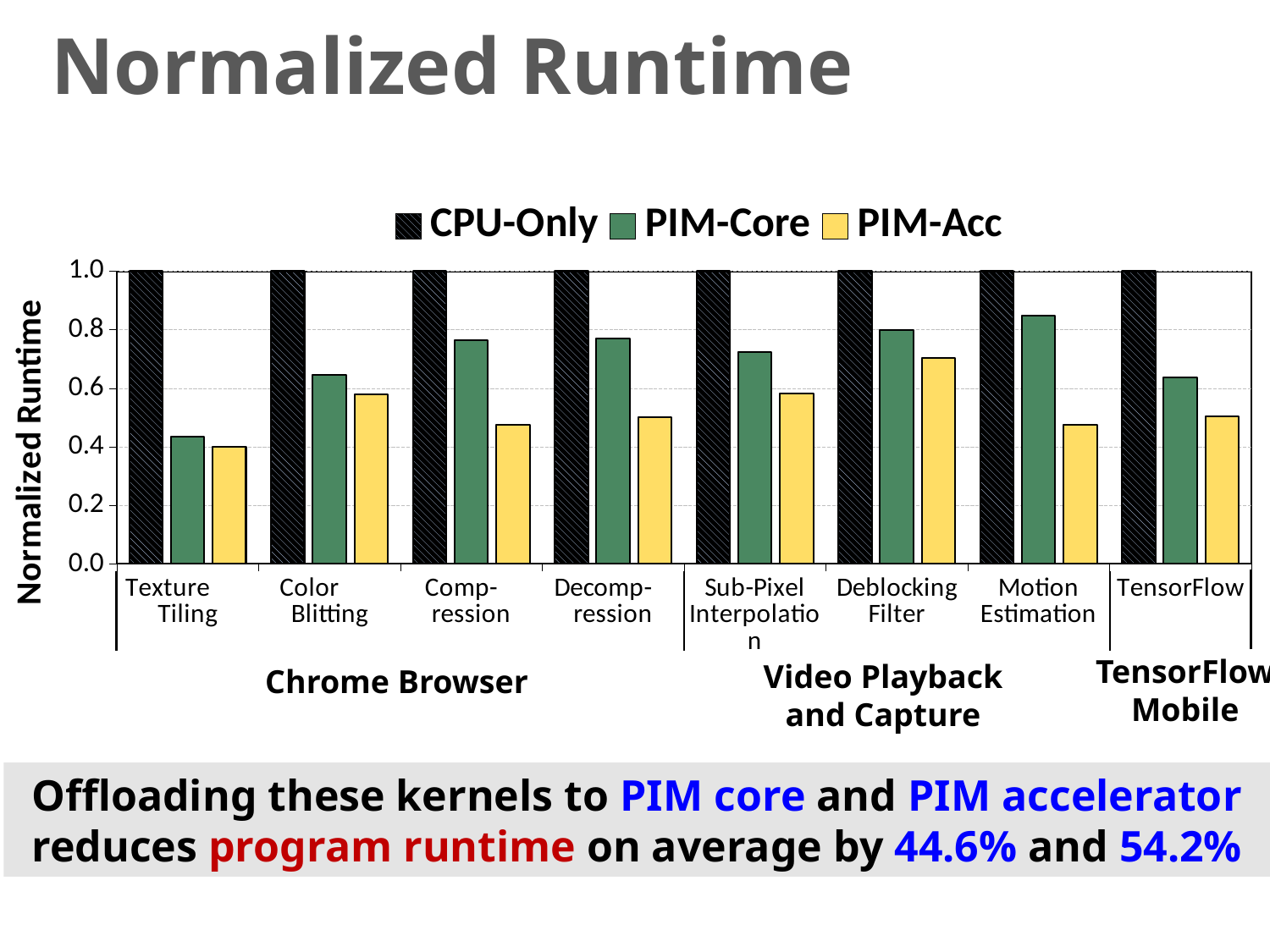
How many kernel categories are plotted along the x axis? 8 What kind of chart is shown on the slide? bar chart What is the label of the y axis? Normalized Runtime For Compression, which is larger: the PIM-Core value or the PIM-Acc value? PIM-Core Which kernel has the lowest PIM-Acc normalized runtime? Texture Tiling Which kernel has the highest PIM-Core normalized runtime? Motion Estimation Is the PIM-Core value for Compression greater or less than 0.6? greater What is the CPU-Only normalized runtime for Texture Tiling? 1.0 Which series is shown with black bars in the legend? CPU-Only Is the PIM-Core value for Motion Estimation greater or less than 0.8? greater How many series does the legend list? 3 Is the PIM-Acc value for Texture Tiling greater or less than 0.6? less